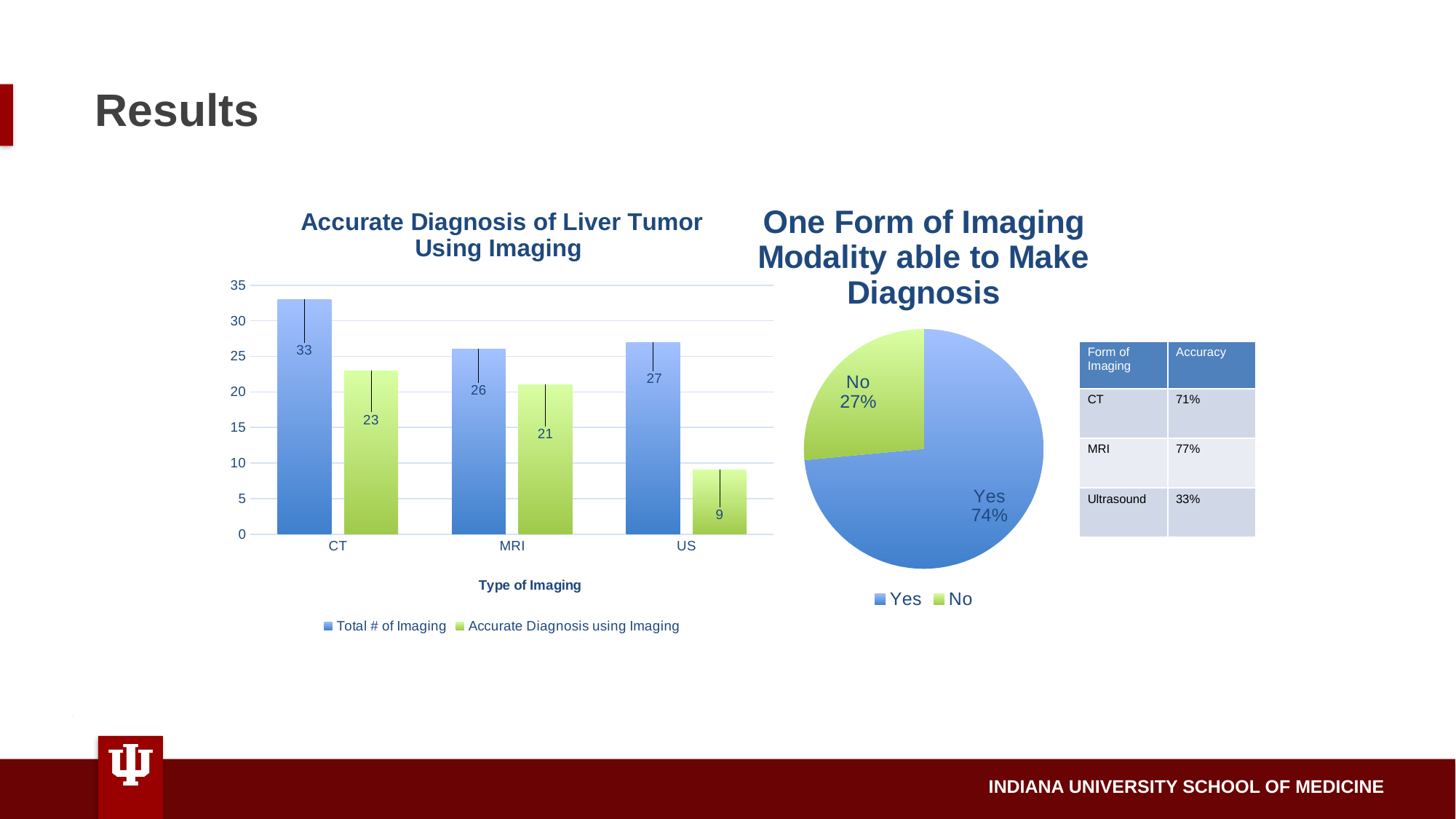
In the 'Accurate Diagnosis of Liver Tumor Using Imaging' chart, what is the difference between the Total # of Imaging and the Accurate Diagnosis using Imaging for MRI? 5 In the 'Accurate Diagnosis of Liver Tumor Using Imaging' chart, what is the Total # of Imaging for CT? 33 In the 'Accurate Diagnosis of Liver Tumor Using Imaging' chart, is the Total # of Imaging larger for MRI or for US? US What kind of chart is 'Accurate Diagnosis of Liver Tumor Using Imaging'? Bar chart In the 'One Form of Imaging Modality able to Make Diagnosis' pie chart, what share is labelled Yes? 74% How many series does the legend of the 'Accurate Diagnosis of Liver Tumor Using Imaging' chart list? 2 In the 'Accurate Diagnosis of Liver Tumor Using Imaging' chart, how many types of imaging are shown on the x axis? 3 In the 'Accurate Diagnosis of Liver Tumor Using Imaging' chart, what is the Accurate Diagnosis using Imaging value for US? 9 What is the x-axis title of the 'Accurate Diagnosis of Liver Tumor Using Imaging' chart? Type of Imaging What kind of chart is 'One Form of Imaging Modality able to Make Diagnosis'? Pie chart In the 'Accurate Diagnosis of Liver Tumor Using Imaging' chart, which type of imaging has the lowest Accurate Diagnosis using Imaging value? US In the 'Accurate Diagnosis of Liver Tumor Using Imaging' chart, which type of imaging has the highest Total # of Imaging? CT